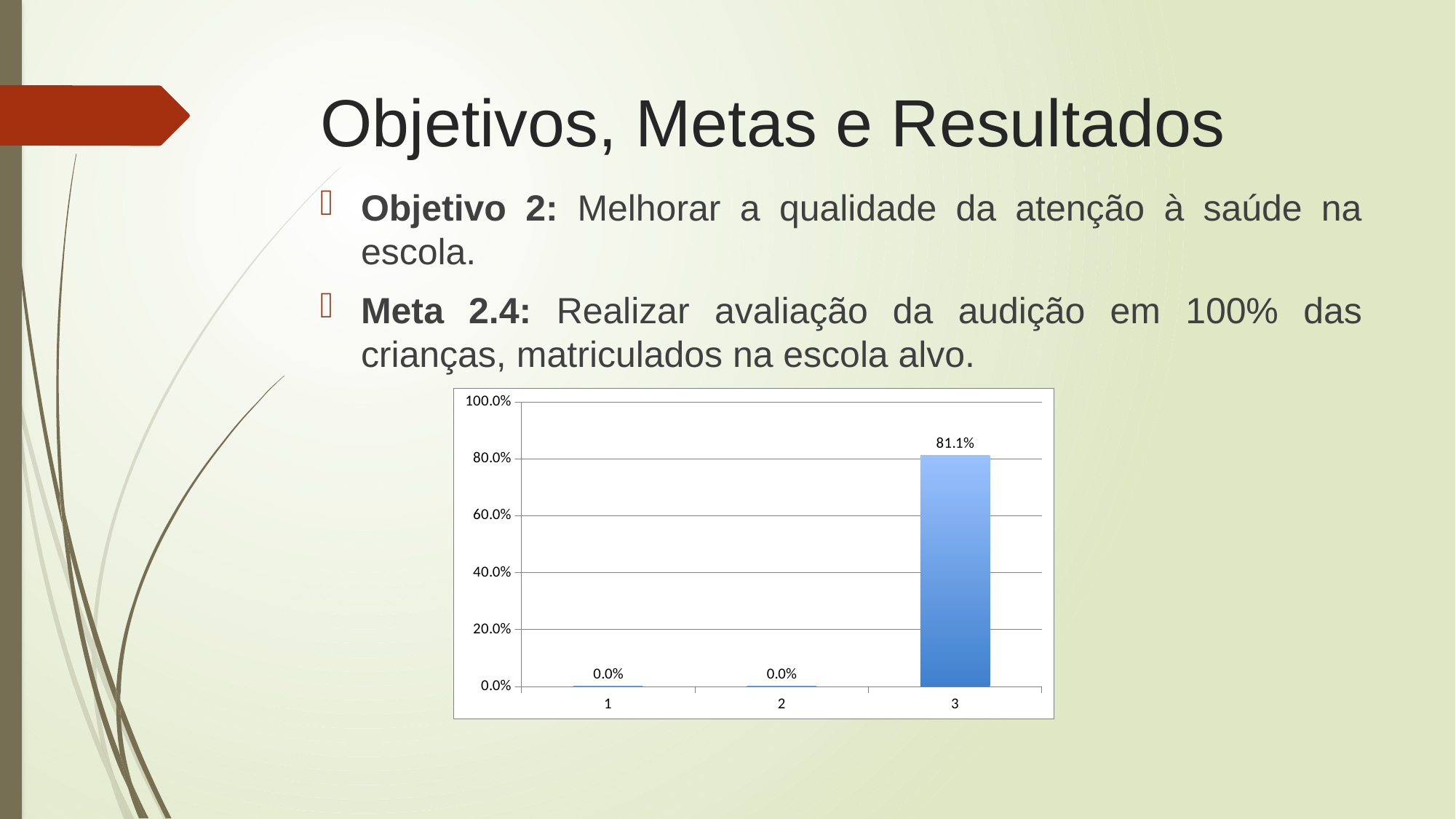
Is the value for category 3 greater or less than 100.0%? less What is the highest value shown on the y axis? 100.0% How many categories are shown on the x axis? 3 What is the value for category 2? 0.0% What is the difference between the values for category 3 and category 1? 81.1% Which is larger, the value for category 3 or the value for category 2? Category 3 Do the values rise or fall from category 1 to category 3? Rise Is the value for category 3 greater or less than 80.0%? greater Which category has the highest value? 3 What is the value for category 3? 81.1% What kind of chart is shown on the slide? Bar chart What is the value for category 1? 0.0%